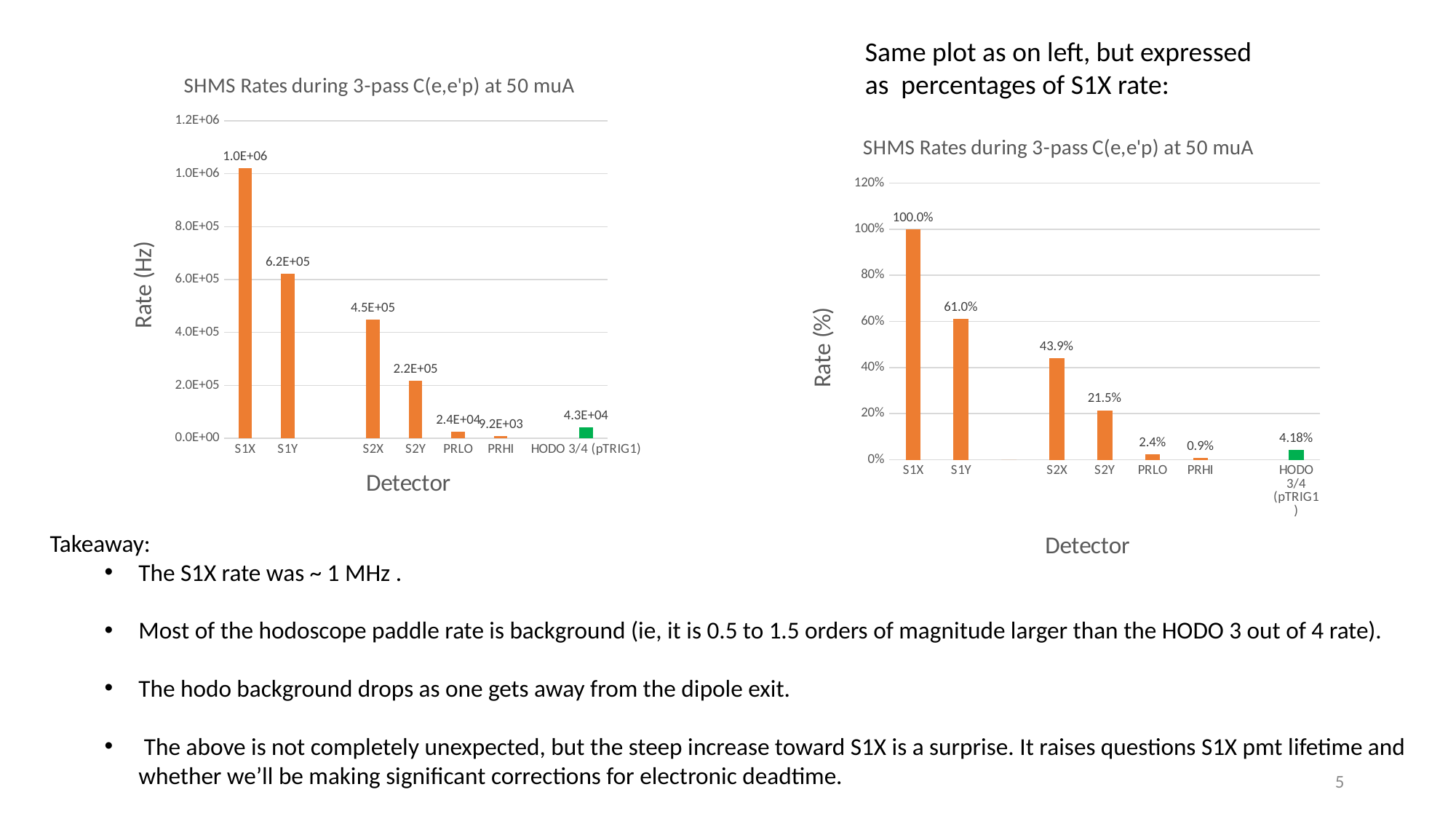
In the left chart, what is the rate for PRHI? 9.2E+03 In the right chart, which detector has the lowest rate? PRHI In the right chart, is the value for S2Y greater or less than 20%? greater In the left chart, what is the rate for HODO 3/4 (pTRIG1)? 4.3E+04 How many detector categories are plotted in the left chart? 7 In the right chart, what is the difference between the S1Y and S2X percentages? 17.1% In the left chart, which is larger, the rate for PRLO or the rate for HODO 3/4 (pTRIG1)? HODO 3/4 (pTRIG1) In the left chart, which detector has the highest rate? S1X What kind of chart is the right chart? bar chart In the right chart, what percentage is shown for HODO 3/4 (pTRIG1)? 4.18% In the right chart, what percentage is shown for S2X? 43.9% In the left chart, what is the rate for S1X? 1.0E+06